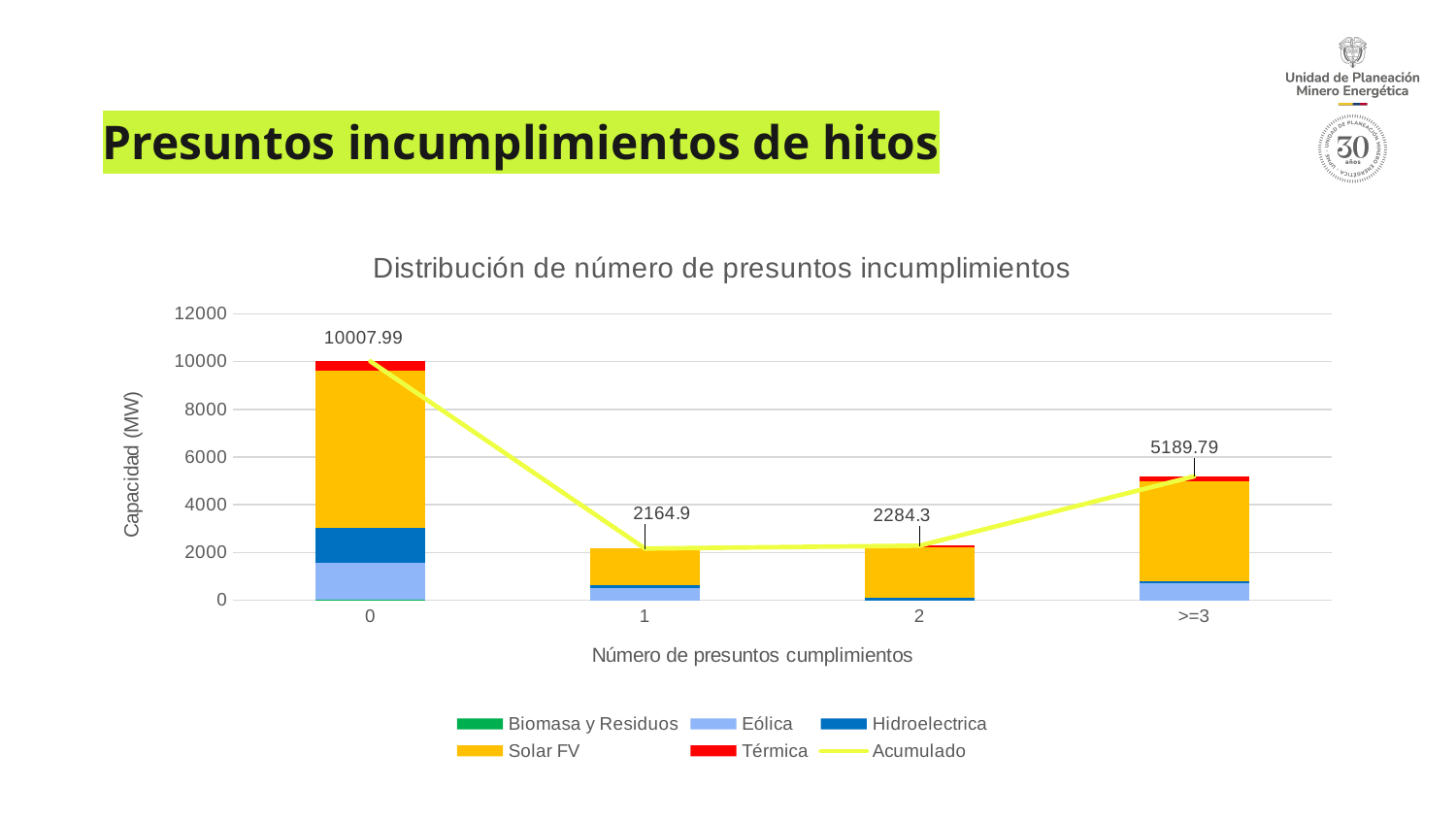
How many series does the legend list? 6 What is the labelled value for category 1? 2164.9 Which category has the lowest labelled value? 1 What is the labelled value for category 0? 10007.99 What is the difference between the labelled values for category 0 and category >=3? 4818.2 What is the labelled value for category >=3? 5189.79 What is the label of the y axis? Capacidad (MW) What is the title of the chart? Distribución de número de presuntos incumplimientos How many categories are shown on the x axis? 4 What is the labelled value for category 2? 2284.3 Which is larger, the labelled value for category 2 or for category 1? 2 Which category has the highest labelled value? 0